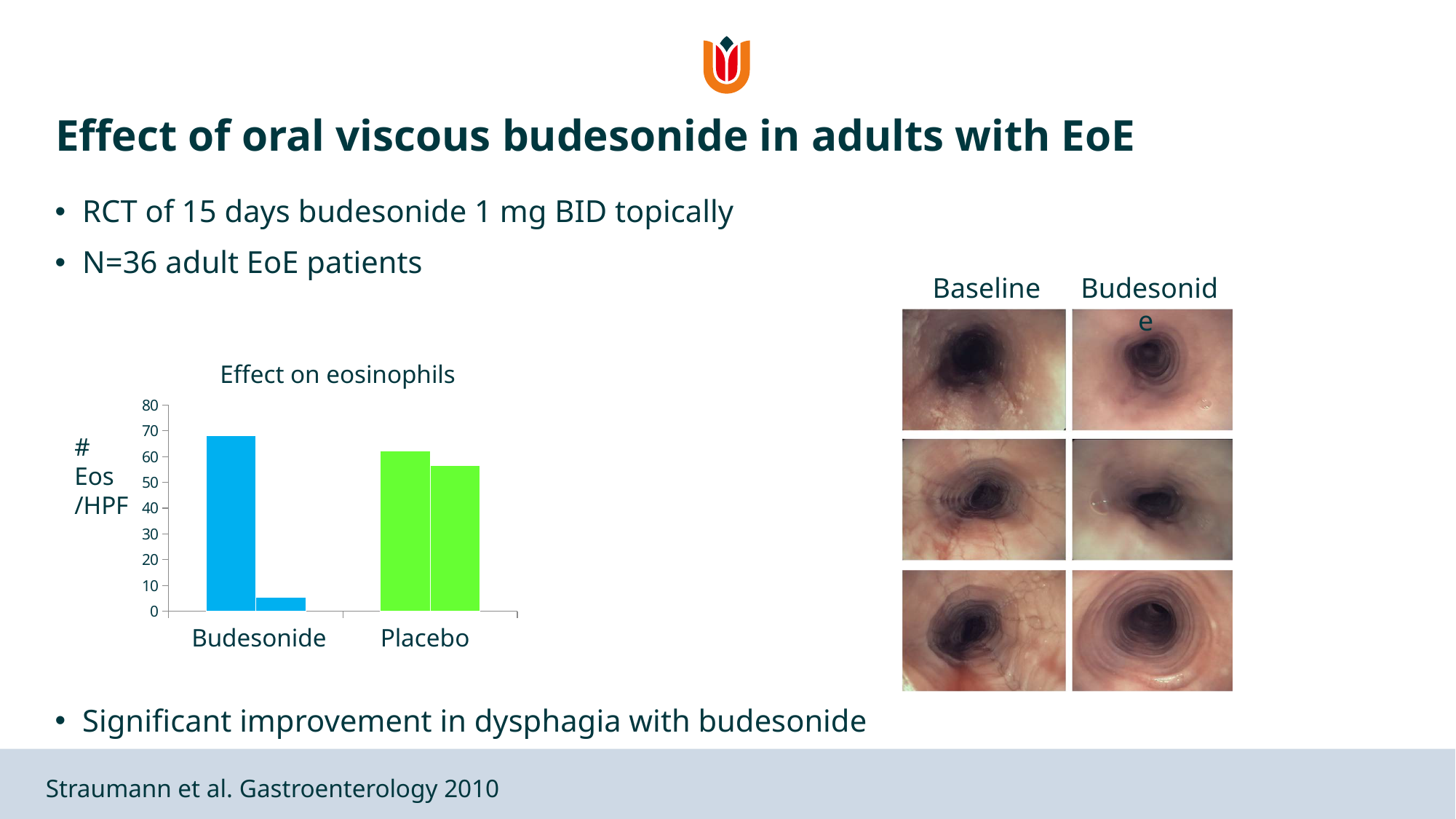
In the "Effect on eosinophils" chart, is the value of the first (left) Budesonide bar greater or less than 60? greater In the "Effect on eosinophils" chart, is the value of the first (left) Placebo bar greater or less than 70? less What is the highest value shown on the vertical axis of the "Effect on eosinophils" chart? 80 In the "Effect on eosinophils" chart, which is larger: the second (right) Budesonide bar or the second (right) Placebo bar? the second Placebo bar In the "Effect on eosinophils" chart, which category contains the shortest bar? Budesonide What is the label on the vertical axis of the "Effect on eosinophils" chart? # Eos /HPF In the "Effect on eosinophils" chart, is the value of the second (right) Placebo bar greater or less than 50? greater What is the title of the chart on the slide? Effect on eosinophils In the "Effect on eosinophils" chart, which is larger: the first (left) Budesonide bar or the first (left) Placebo bar? the first Budesonide bar What kind of chart is shown under the title "Effect on eosinophils"? bar chart How many categories are shown on the x axis of the "Effect on eosinophils" chart? 2